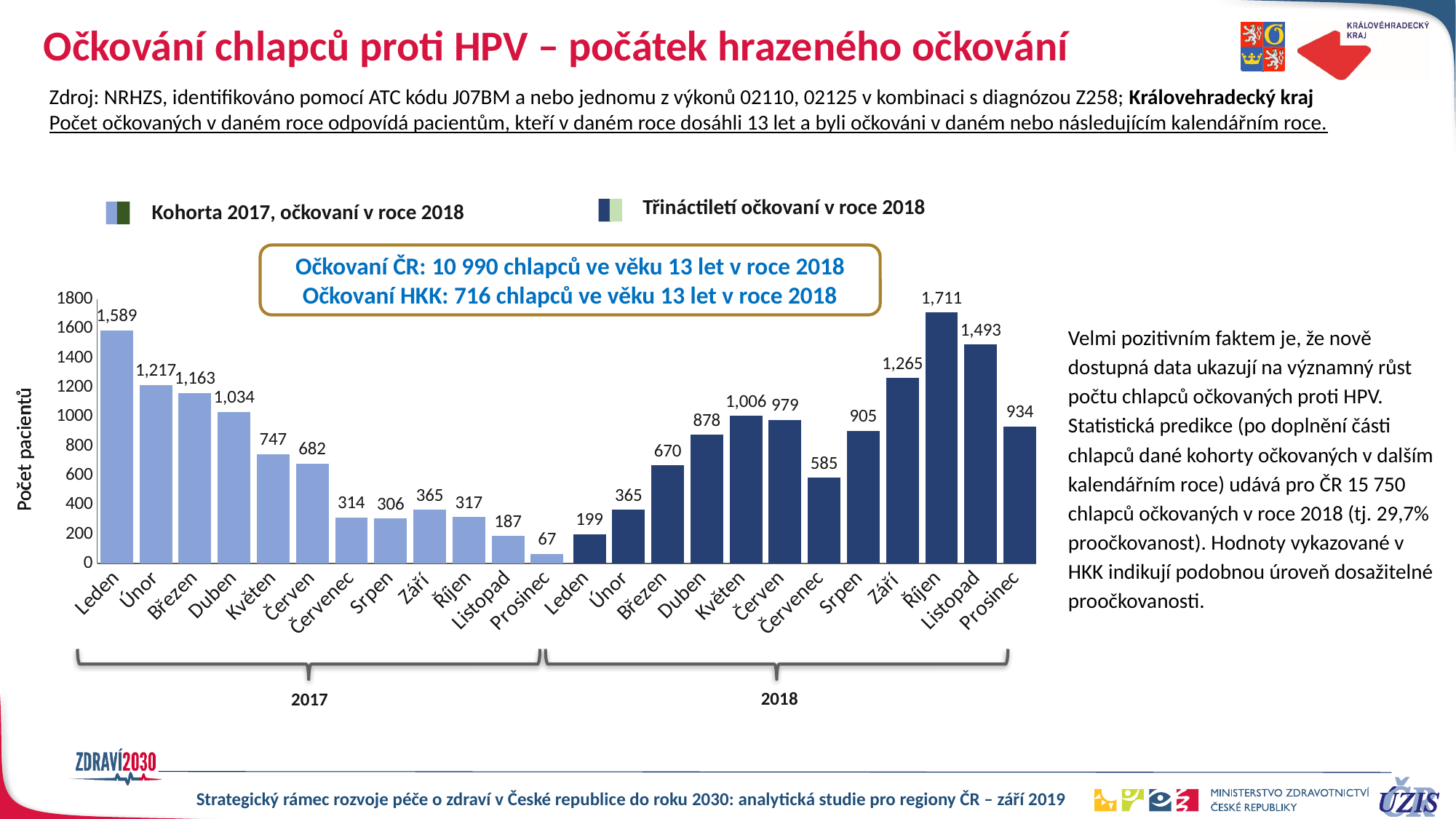
What is the value for Říjen (October) 2018 in the chart? 1,711 What is the value for Prosinec (December) 2017 in the chart? 67 Which is larger: the value for Květen 2018 or the value for Červen 2018? Květen 2018 Which month in 2018 has the highest value in the chart? Říjen Do the values for the 2018 months generally rise or fall from Leden to Říjen? rise What type of chart is shown on the slide? bar chart What is the label of the y axis of the chart? Počet pacientů What is the difference between the values for Říjen 2018 (1,711) and Listopad 2018 (1,493)? 218 How many series does the chart legend list? 2 What is the value for Leden (January) 2017 in the chart? 1,589 Which month in 2017 has the lowest value in the chart? Prosinec How many bars are plotted in the chart in total? 24